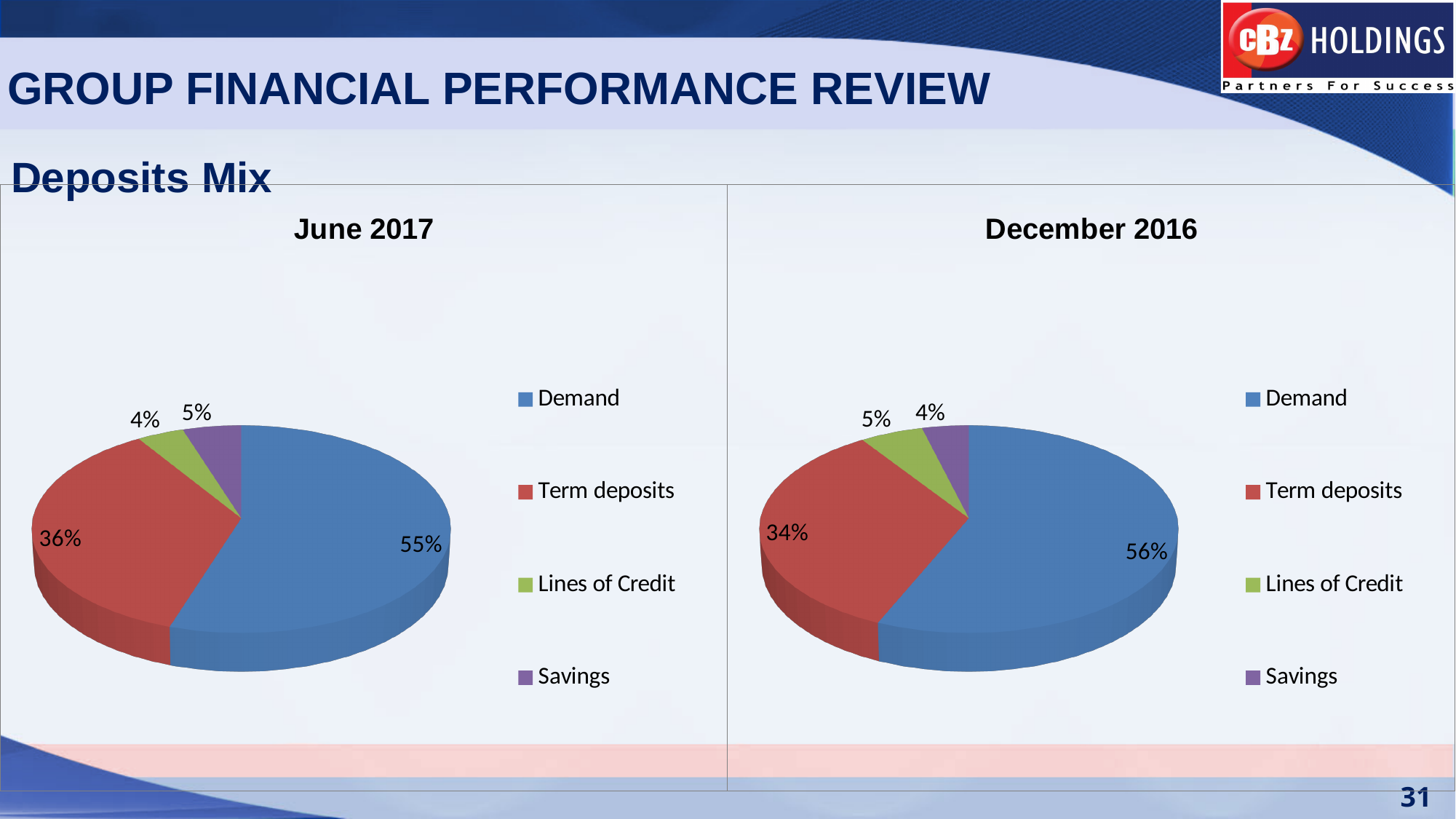
How many categories does the December 2016 chart show? 4 In the December 2016 chart, what share of deposits is Lines of Credit? 5% In the June 2017 chart, what is the difference between the Demand share and the Term deposits share? 19% Is the Term deposits share larger in June 2017 or in December 2016? June 2017 In the June 2017 chart, what share of deposits is Demand? 55% In the June 2017 chart, what share of deposits is Savings? 5% What type of chart is the June 2017 chart? Pie chart In the December 2016 chart, what share of deposits is Term deposits? 34% In the June 2017 chart, which category has the largest share? Demand What is the difference between the Demand share in December 2016 and the Demand share in June 2017? 1% In the June 2017 chart, which category has the smallest share? Lines of Credit In the December 2016 chart, which category has the smallest share? Savings